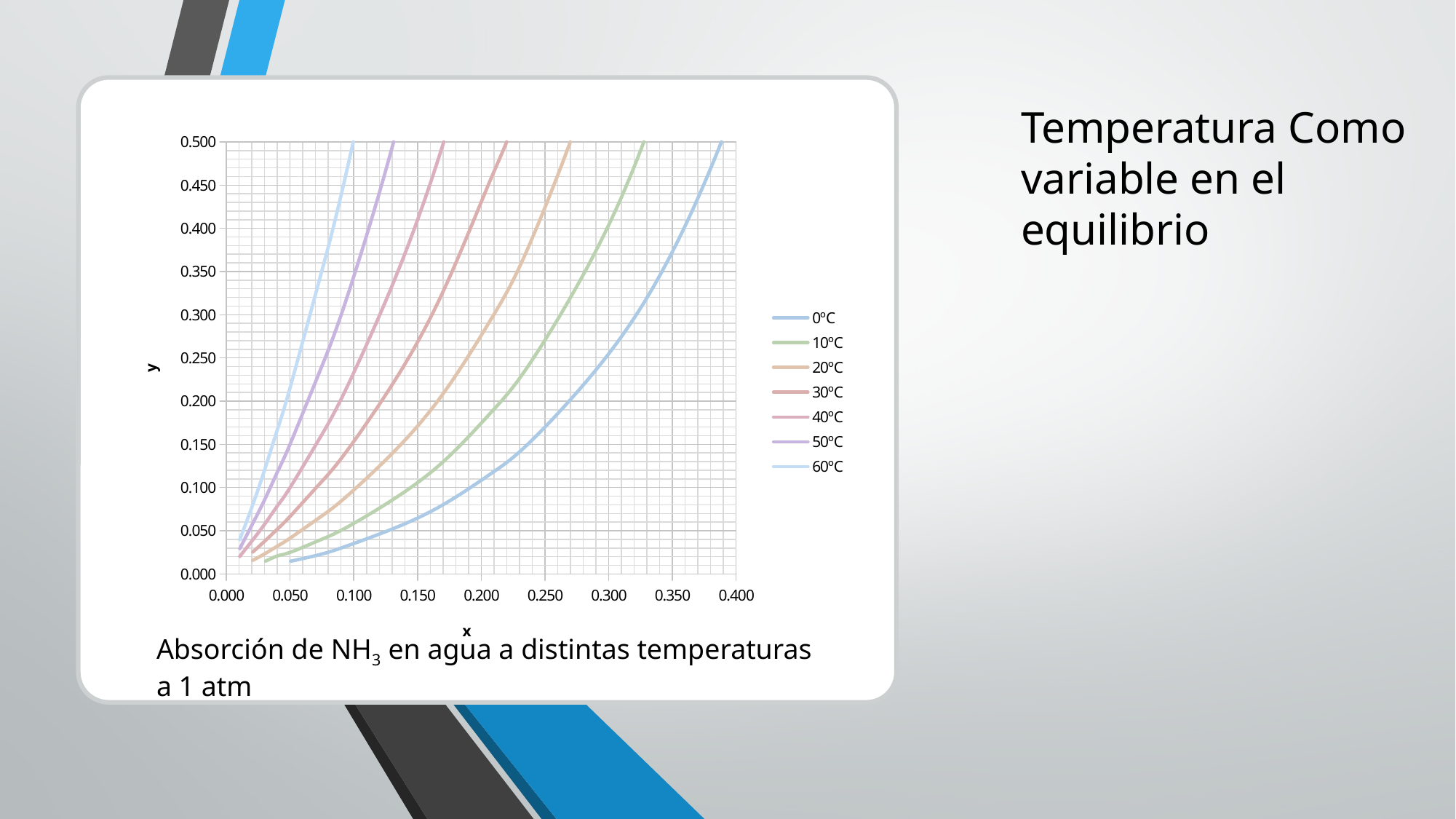
At x = 0.200, is the y value of the 0°C curve greater or less than 0.150? less At x = 0.150, which curve has the larger y value, the 0°C curve or the 30°C curve? 30°C Is the x value at which the 0°C curve reaches y = 0.500 greater or less than 0.350? greater Which temperature curve reaches y = 0.500 at the smallest x value? 60°C What kind of chart is shown on the slide? line chart Which temperature series is listed first in the chart legend? 0°C How many series does the chart legend list? 7 Do the y values of the 0°C curve rise or fall as x increases? rise What is the caption below the chart? Absorción de NH3 en agua a distintas temperaturas a 1 atm Which temperature curve reaches y = 0.500 at the largest x value? 0°C At x = 0.200, is the y value of the 10°C curve greater or less than 0.150? greater